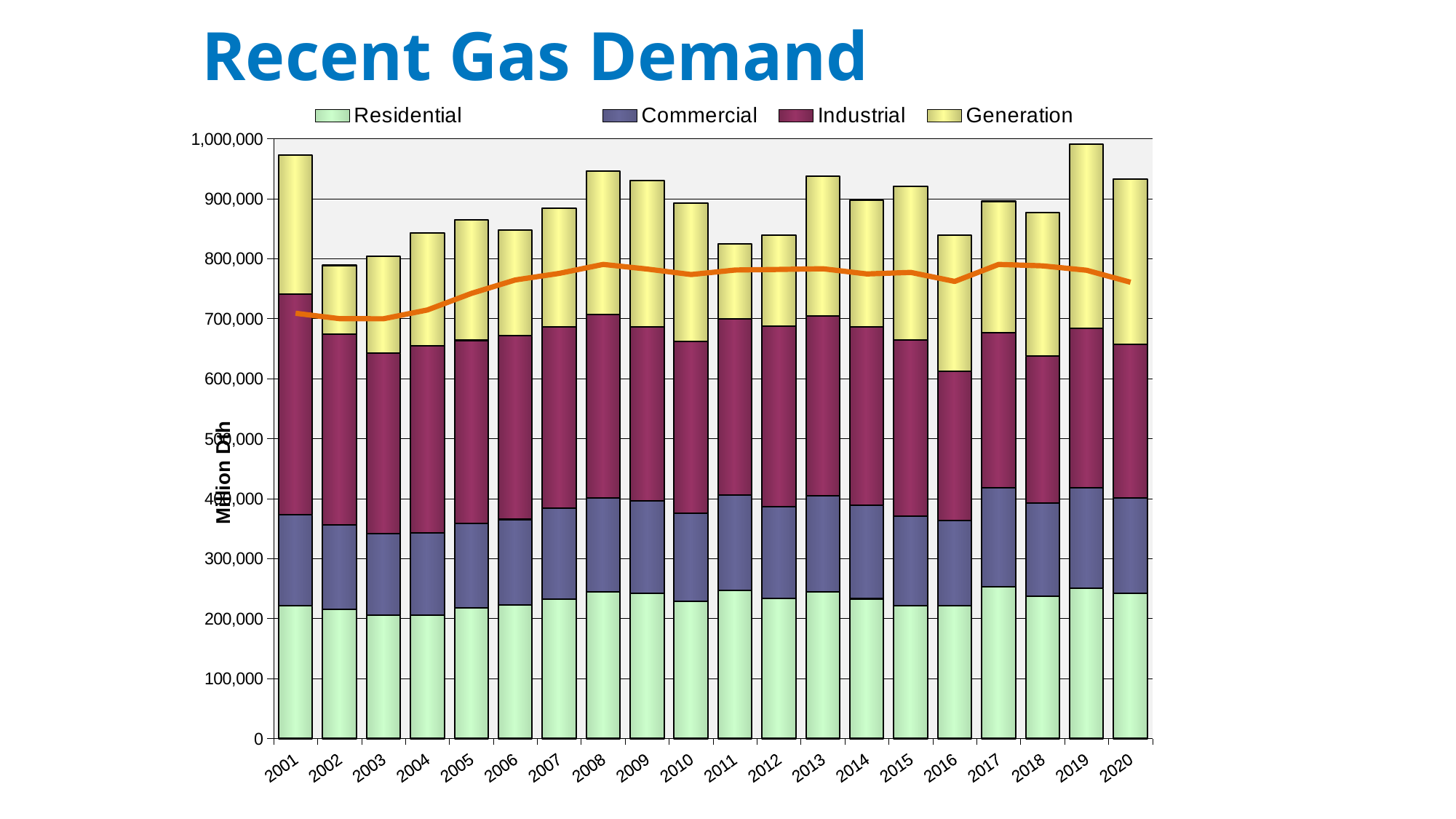
How many years are shown along the x axis? 20 Is the total value for 2016 greater or less than 900,000? less Which year has the highest total gas demand? 2019 Is the total value for 2019 greater or less than 900,000? greater Is the total value for 2001 greater or less than 900,000? greater Which year has the larger total gas demand, 2001 or 2002? 2001 What kind of chart is shown on the slide? Combination stacked bar and line chart What is the label on the vertical axis? Million Dth Which year has the larger total gas demand, 2008 or 2011? 2008 How many series does the legend list? 4 Which year has the lowest total gas demand? 2002